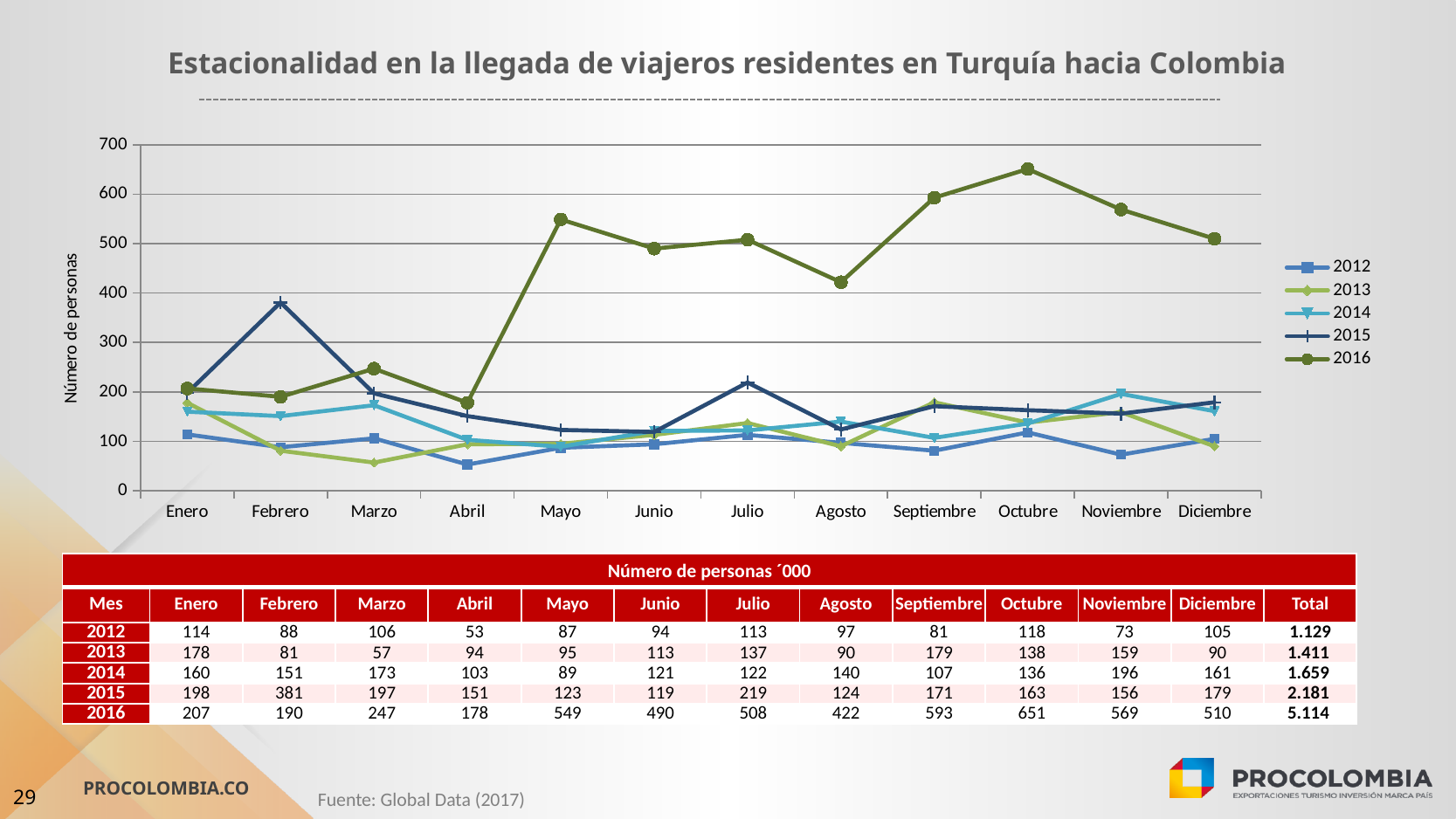
How many series does the legend of the chart list? 5 Is the value for 2016 in Octubre greater or less than 600? greater Does the 2016 series rise or fall from Octubre to Diciembre? fall In which month does the 2016 series reach its highest value? Octubre What is the value for 2015 in Febrero? 381 How many months are plotted along the x axis of the chart? 12 Which is larger in Febrero, the value for 2015 or the value for 2016? 2015 What kind of chart is shown on the slide? line chart What is the label on the y axis of the chart? Número de personas What is the difference between the 2016 values for Mayo and Abril? 371 What is the value for 2016 in Octubre? 651 In which month does the 2012 series have its lowest value? Abril